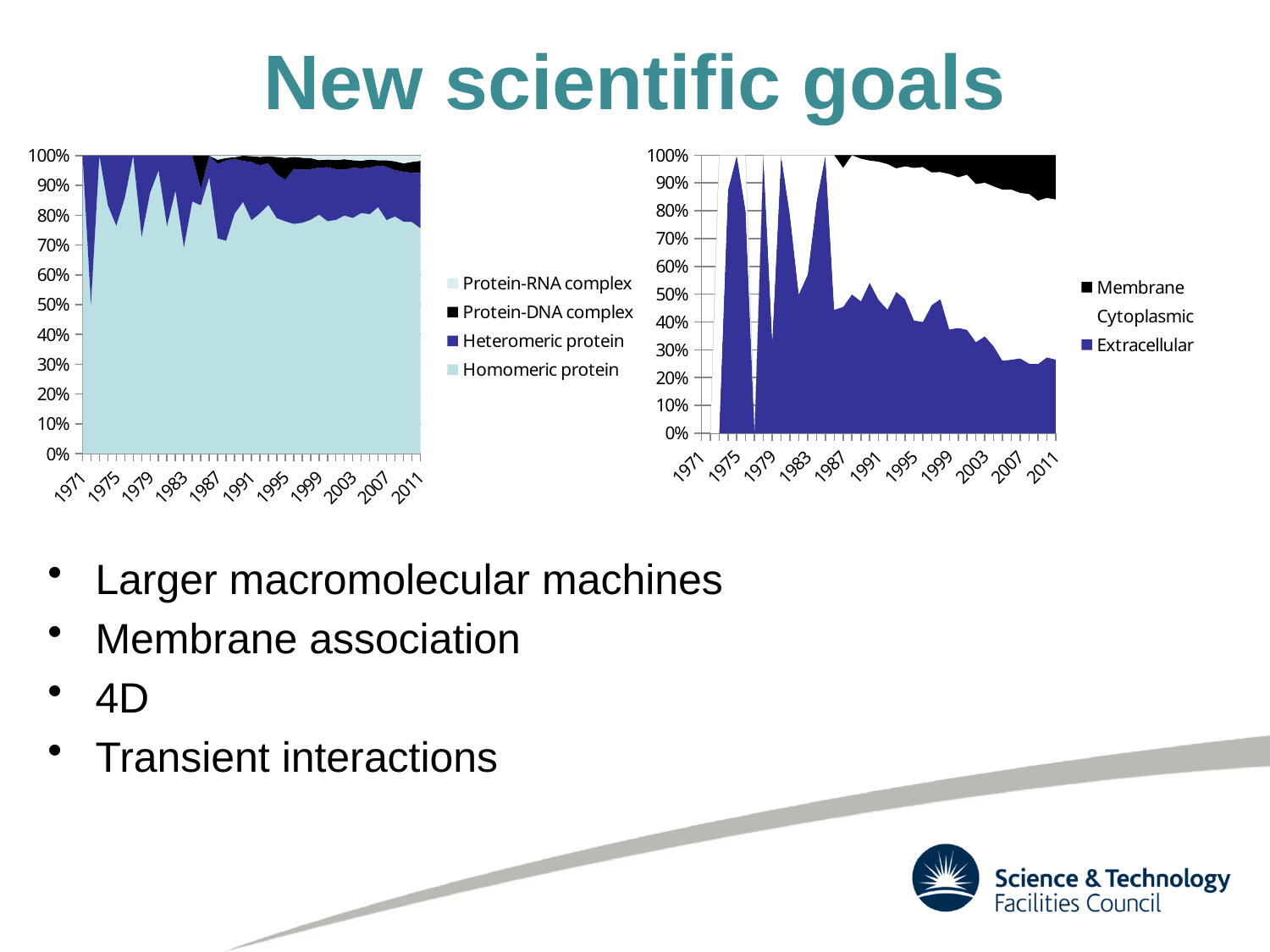
What kind of chart is the right chart on the slide? Stacked area chart In the right chart, does the Membrane share rise or fall from the late 1980s to 2011? rise What kind of chart is the left chart on the slide? Stacked area chart In the left chart, which series is shown in black in the legend? Protein-DNA complex In the left chart, is the share for Homomeric protein in 2011 greater or less than 50%? greater In the right chart, is the share for Extracellular in 2011 greater or less than 50%? less In the left chart, which series occupies the largest share of the area across the years shown? Homomeric protein How many series does the legend of the right chart list? 3 How many series does the legend of the left chart list? 4 In the right chart, does the Extracellular share generally rise or fall from the early 1980s to 2011? fall In the right chart, is the share for Extracellular in 2011 greater or less than 20%? greater What is the first year label on the x axis of the right chart? 1971